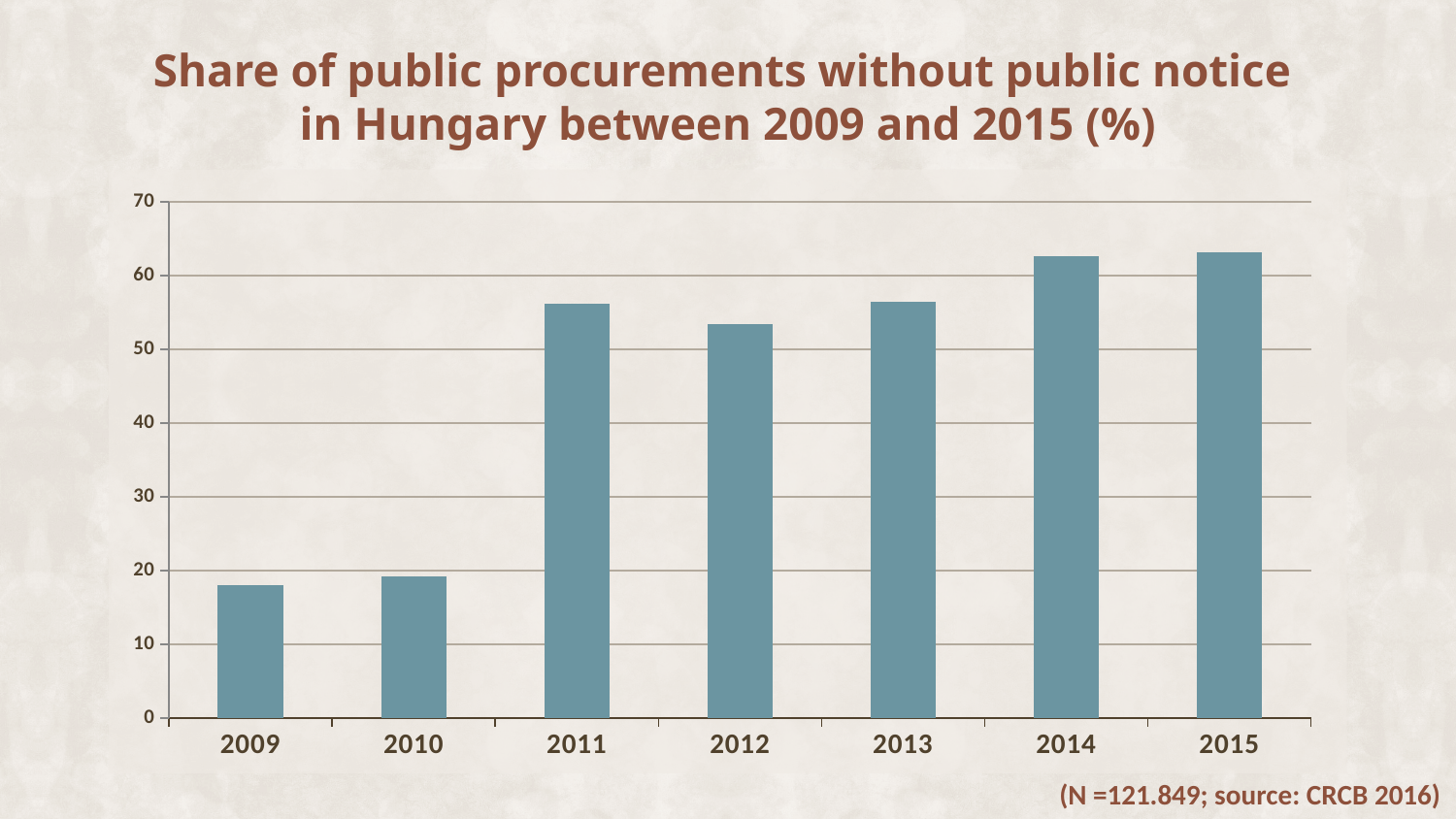
Is the value for 2010 greater or less than 20? less Is the value for 2012 greater or less than 60? less How many years are shown on the x axis of the chart? 7 Overall, do the values rise or fall from 2009 to 2015? rise What is the title of the chart? Share of public procurements without public notice in Hungary between 2009 and 2015 (%) Is the value for 2014 greater or less than 60? greater Which year has the larger value, 2010 or 2014? 2014 Which year has the larger value, 2011 or 2012? 2011 What kind of chart is shown on the slide? bar chart